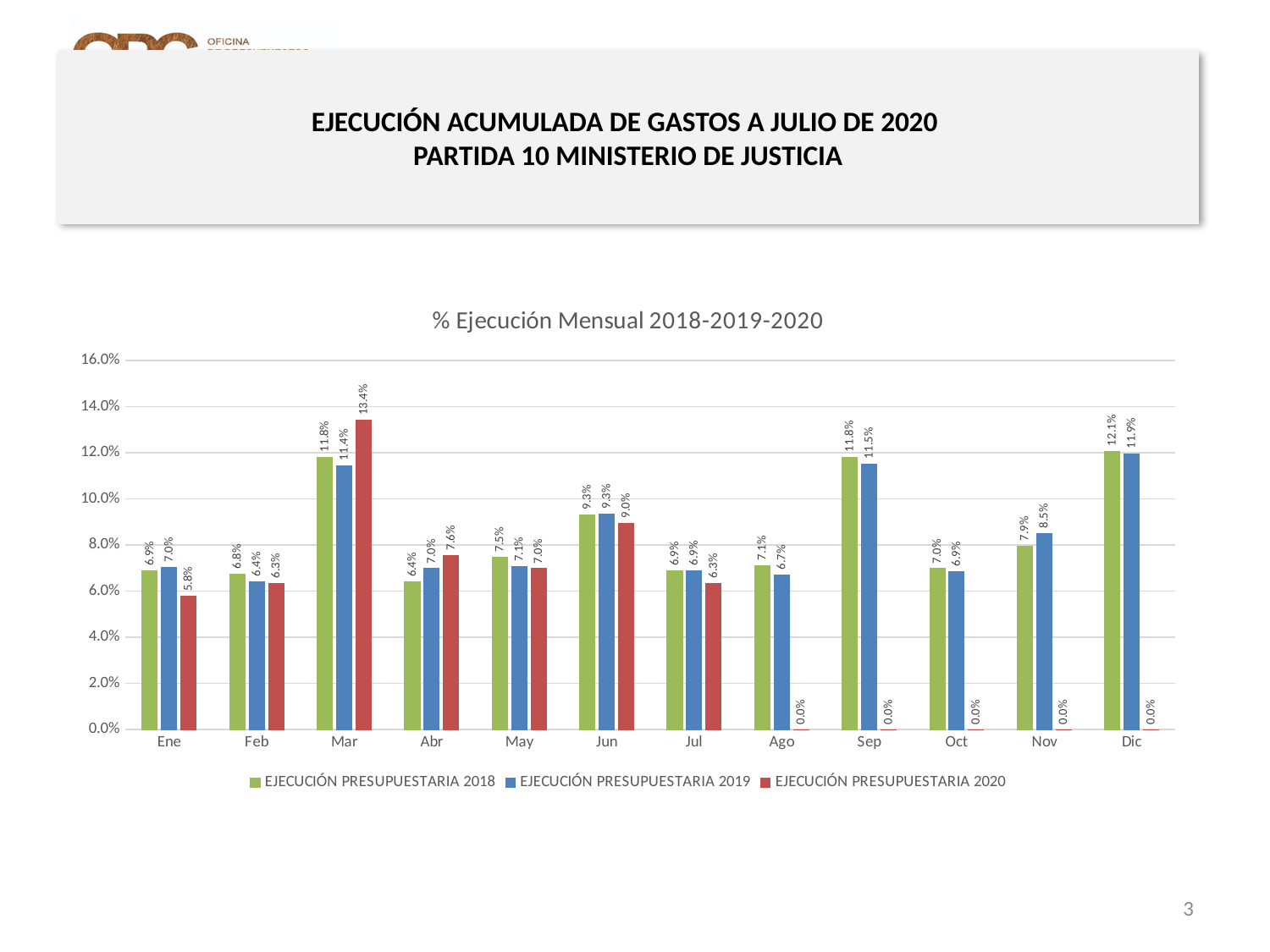
Which month has the lowest value for EJECUCIÓN PRESUPUESTARIA 2019? Feb Is the value for EJECUCIÓN PRESUPUESTARIA 2019 in Sep greater or less than 10.0%? greater What kind of chart is shown? bar chart What is the title of the chart? % Ejecución Mensual 2018-2019-2020 Which month has the highest value for EJECUCIÓN PRESUPUESTARIA 2018? Dic What is the value for EJECUCIÓN PRESUPUESTARIA 2019 in Nov? 8.5% Which is larger in Abr: the 2018 value or the 2020 value? 2020 How many series does the legend list? 3 What is the difference between the 2020 and 2018 values in Mar? 1.6% How many months are shown on the x axis? 12 What is the value for EJECUCIÓN PRESUPUESTARIA 2020 in Mar? 13.4% What is the value for EJECUCIÓN PRESUPUESTARIA 2018 in Dic? 12.1%